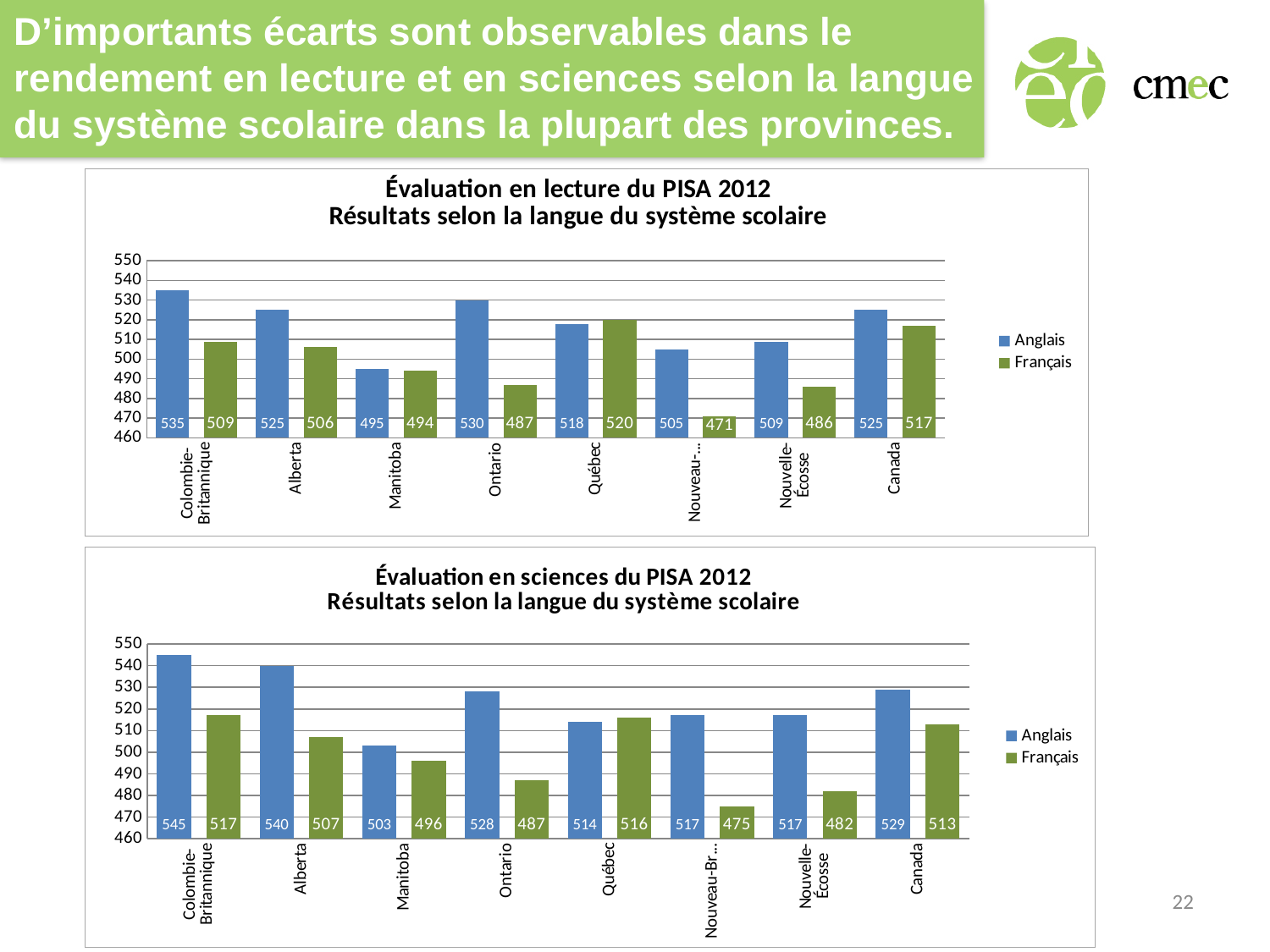
In the bottom chart (Évaluation en sciences du PISA 2012), what is the Anglais value for Colombie-Britannique? 545 In the top chart (Évaluation en lecture du PISA 2012), how many series does the legend list? 2 In the top chart (Évaluation en lecture du PISA 2012), which province has the highest Anglais value? Colombie-Britannique In the bottom chart (Évaluation en sciences du PISA 2012), what is the difference between the Anglais and Français values for Alberta? 33 In the bottom chart (Évaluation en sciences du PISA 2012), which province has the lowest Anglais value? Manitoba What kind of chart is the bottom chart (Évaluation en sciences du PISA 2012)? Bar chart In the top chart (Évaluation en lecture du PISA 2012), what is the Anglais value for Ontario? 530 In the top chart (Évaluation en lecture du PISA 2012), which is larger for Québec, the Anglais value or the Français value? Français In the top chart (Évaluation en lecture du PISA 2012), what is the Français value for Québec? 520 In the top chart (Évaluation en lecture du PISA 2012), what is the difference between the Anglais and Français values for Ontario? 43 In the bottom chart (Évaluation en sciences du PISA 2012), how many categories are shown on the x axis? 8 In the bottom chart (Évaluation en sciences du PISA 2012), what is the Français value for Canada? 513